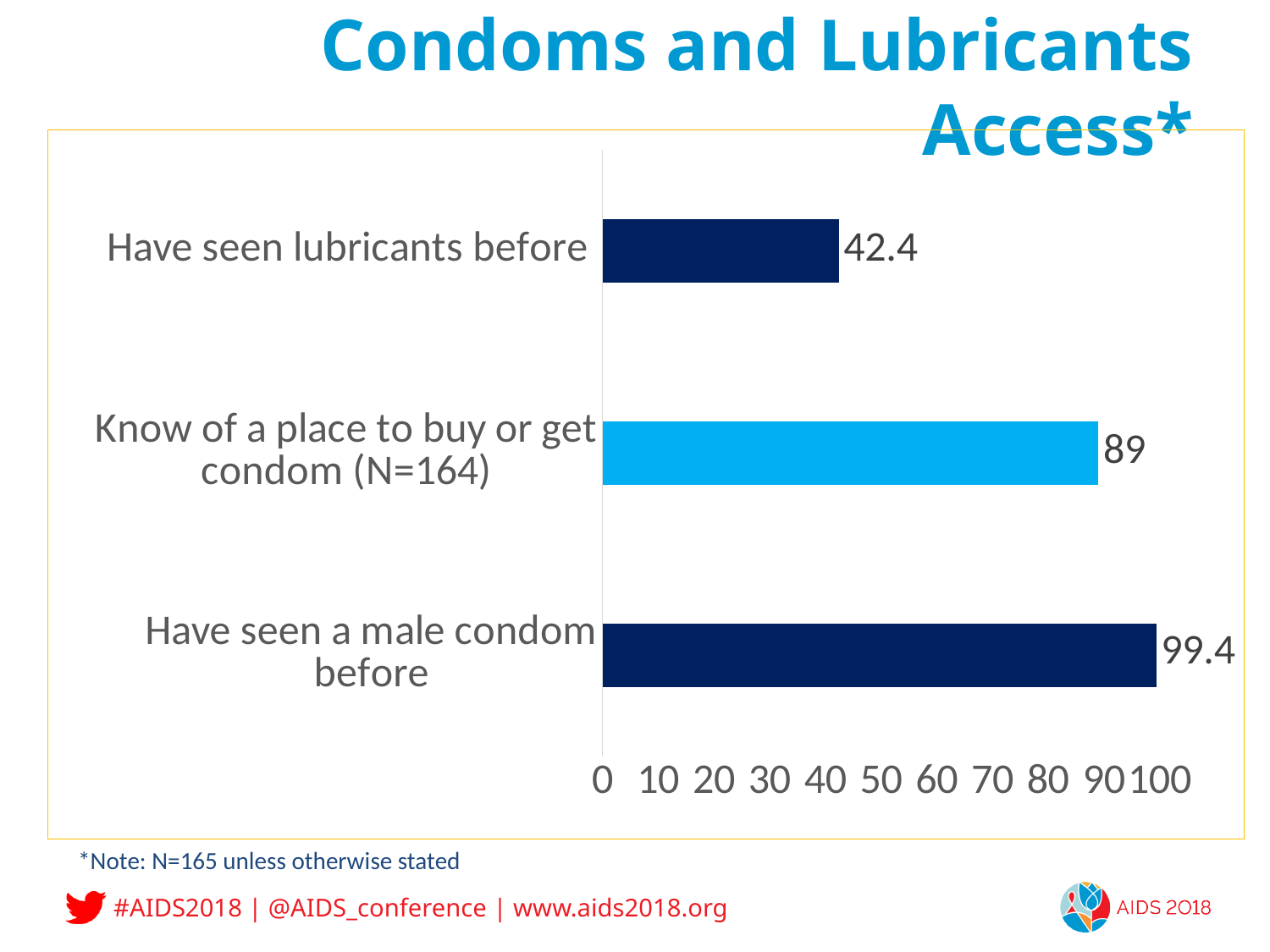
What kind of chart is shown on the slide? bar chart What is the value for "Know of a place to buy or get condom (N=164)"? 89 How many categories are shown in the chart? 3 What is the title of the slide containing the chart? Condoms and Lubricants Access* Which category has the lowest value? Have seen lubricants before What is the value for "Have seen lubricants before"? 42.4 What is the difference between the values for "Have seen a male condom before" and "Have seen lubricants before"? 57 Is the value for "Have seen lubricants before" greater or less than 50? less What is the difference between the values for "Know of a place to buy or get condom (N=164)" and "Have seen lubricants before"? 46.6 Which category has the highest value? Have seen a male condom before What is the value for "Have seen a male condom before"? 99.4 Which is larger: the value for "Know of a place to buy or get condom (N=164)" or the value for "Have seen lubricants before"? Know of a place to buy or get condom (N=164)